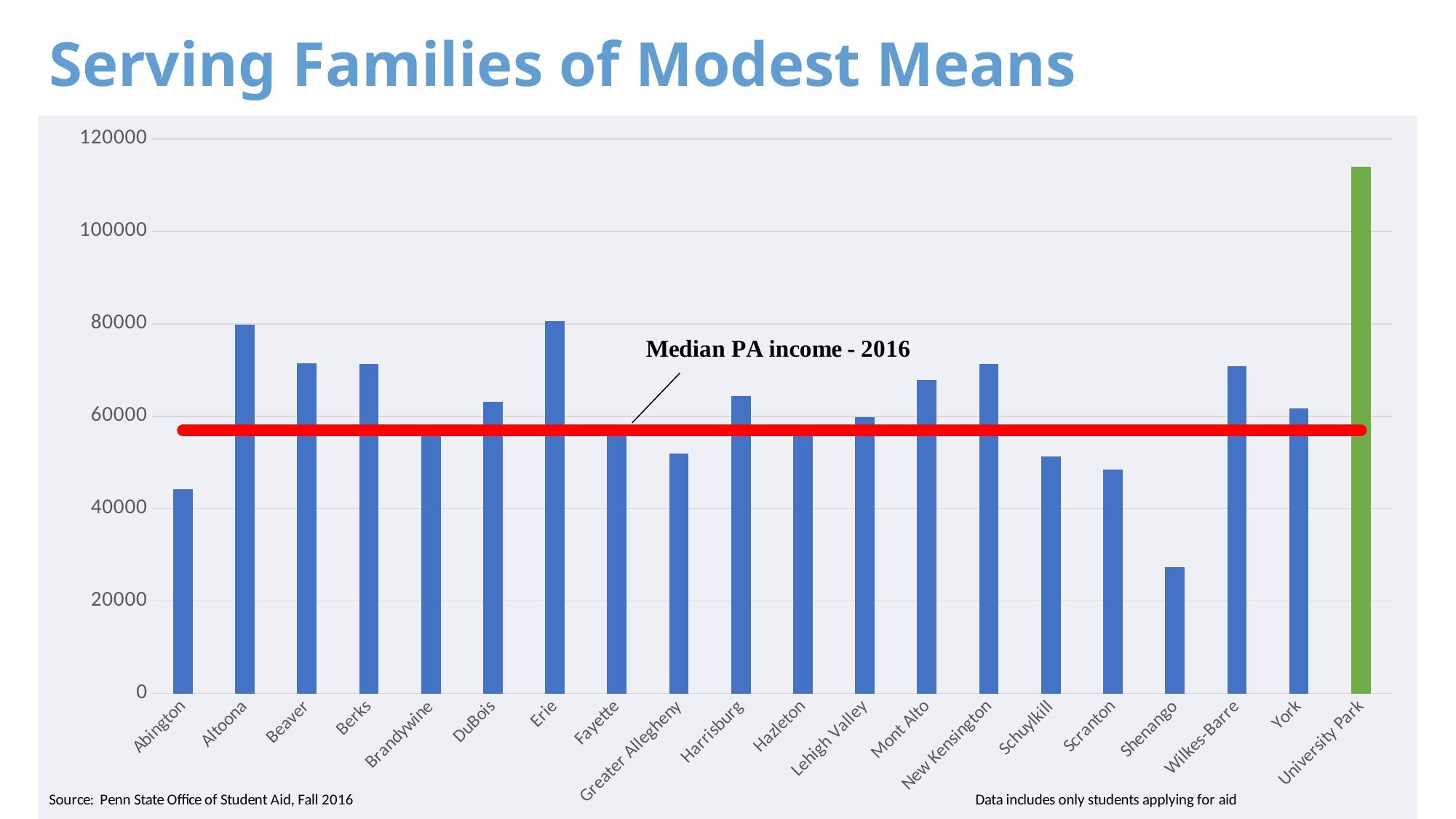
Is the value for Altoona greater or less than 60000? greater Is the value for University Park greater or less than 100000? greater How many campuses (categories) are shown on the x axis of the chart? 20 Which campus has the lowest value in the chart? Shenango Which has the larger value, Scranton or Shenango? Scranton Which has the larger value, Altoona or Abington? Altoona What does the red horizontal line across the chart represent? Median PA income - 2016 Which campus's bar is coloured green rather than blue? University Park Is the value for Abington greater or less than 60000? less What kind of chart is shown on the slide? bar chart Which campus has the highest value in the chart? University Park